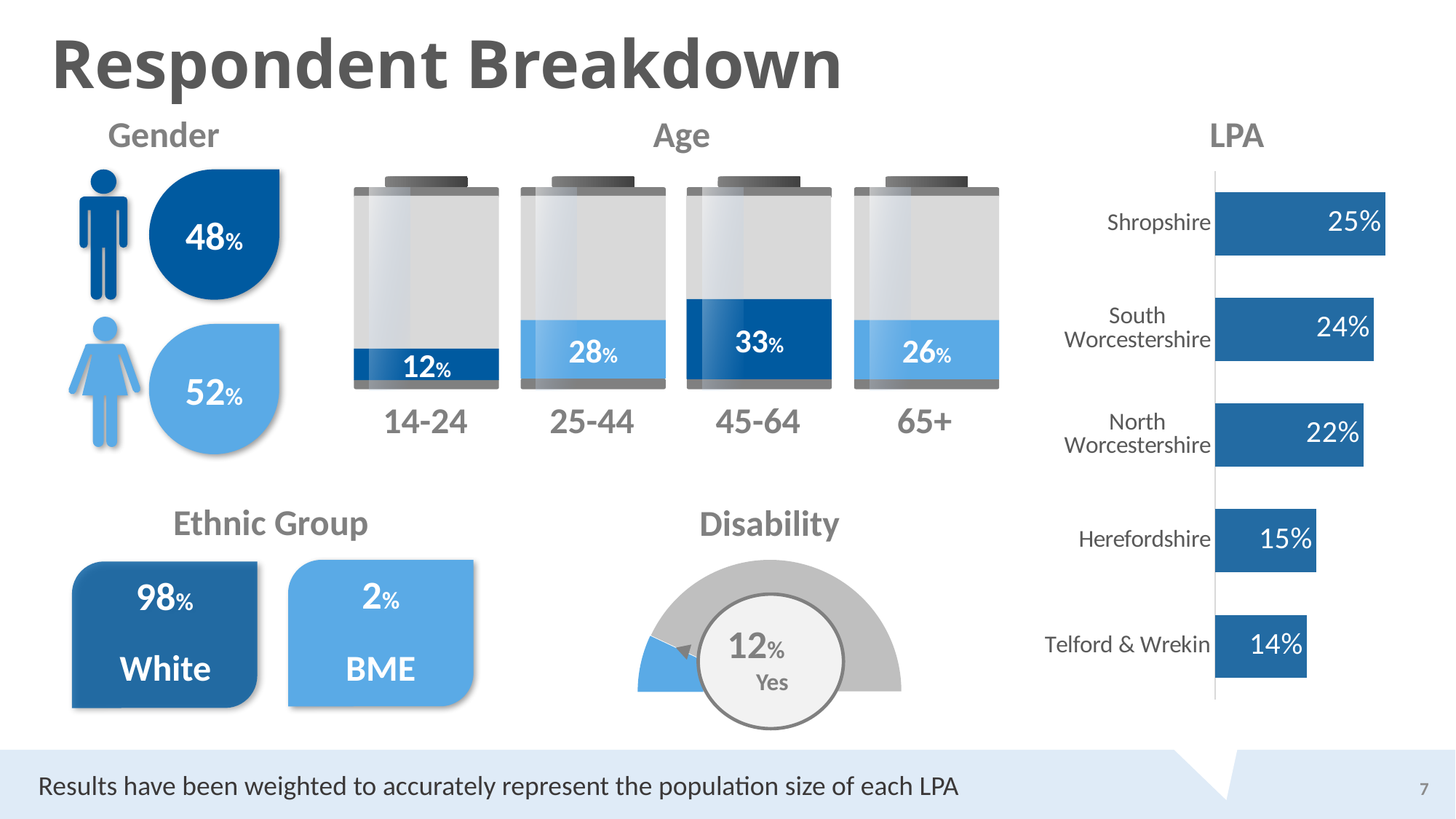
In the LPA chart, which LPA has the highest value? Shropshire In the LPA chart, which LPA has the lowest value? Telford & Wrekin In the Age chart, what is the value for the 45-64 age group? 33% In the Age chart, how many age groups are shown? 4 In the LPA chart, what is the difference between North Worcestershire and Telford & Wrekin? 8% In the Disability chart, what percentage of respondents answered Yes? 12% In the Age chart, which is larger, the value for 25-44 or the value for 65+? 25-44 In the LPA chart, what is the value for Shropshire? 25% In the LPA chart, what is the value for Herefordshire? 15% What kind of chart is the LPA chart? Bar chart In the Age chart, which age group has the lowest value? 14-24 In the LPA chart, how many LPAs are shown? 5